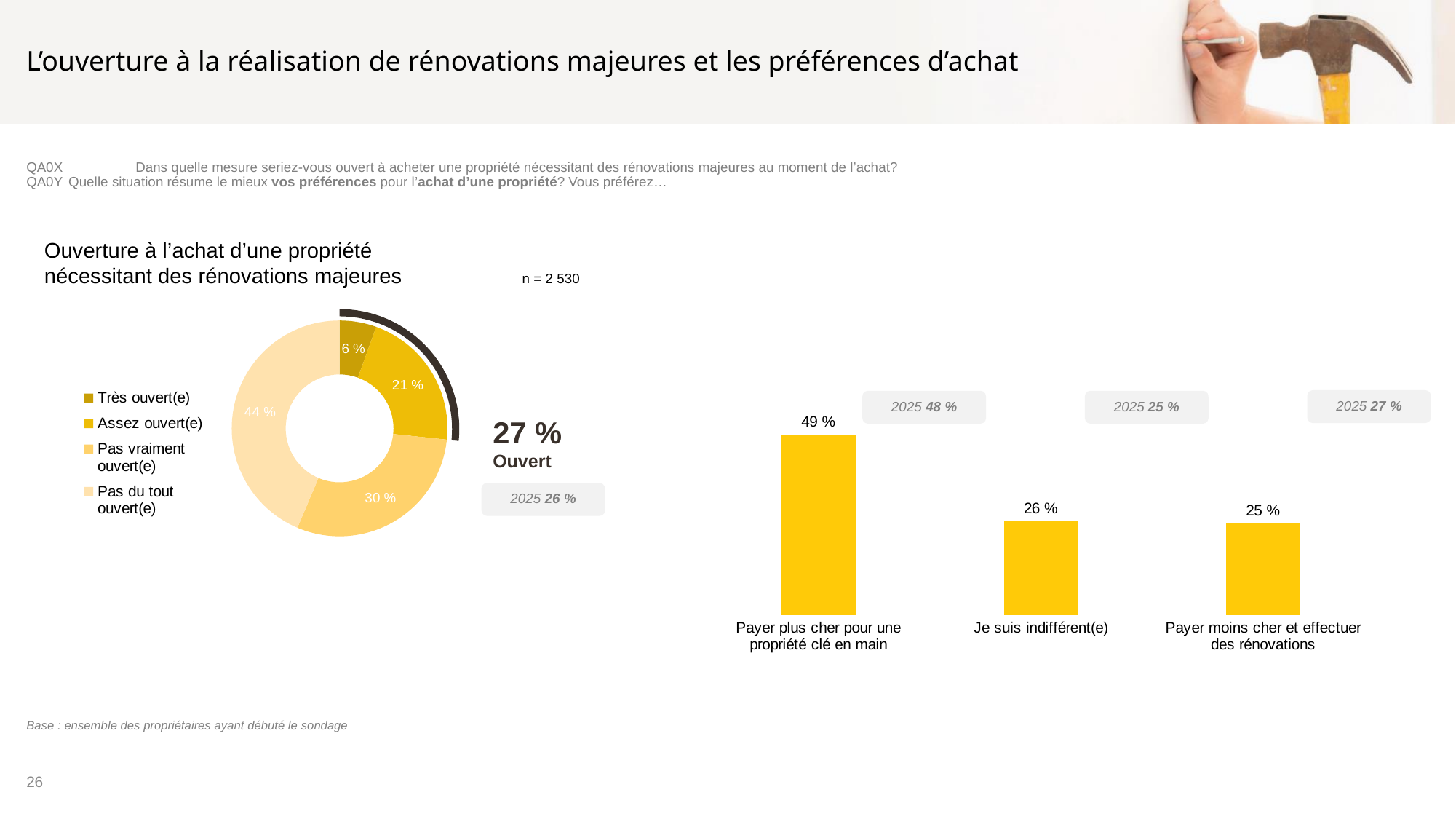
What type of chart is shown on the right side of the slide? Bar chart In the donut chart on the left, what share of respondents are 'Assez ouvert(e)'? 21 % In the bar chart on the right, what is the value for 'Je suis indifférent(e)'? 26 % In the bar chart on the right, what is the value for 'Payer plus cher pour une propriété clé en main'? 49 % In the donut chart on the left, what share of respondents are 'Pas du tout ouvert(e)'? 44 % In the donut chart on the left, which category has the largest share? Pas du tout ouvert(e) In the donut chart on the left, which category has the smallest share? Très ouvert(e) In the bar chart on the right, which category has the highest value? Payer plus cher pour une propriété clé en main In the donut chart on the left, how many categories does the legend list? 4 In the donut chart on the left, what is the combined share labelled as 'Ouvert'? 27 % In the bar chart on the right, what is the difference between 'Payer plus cher pour une propriété clé en main' and 'Payer moins cher et effectuer des rénovations'? 24 % In the donut chart on the left, what share of respondents are 'Très ouvert(e)'? 6 %